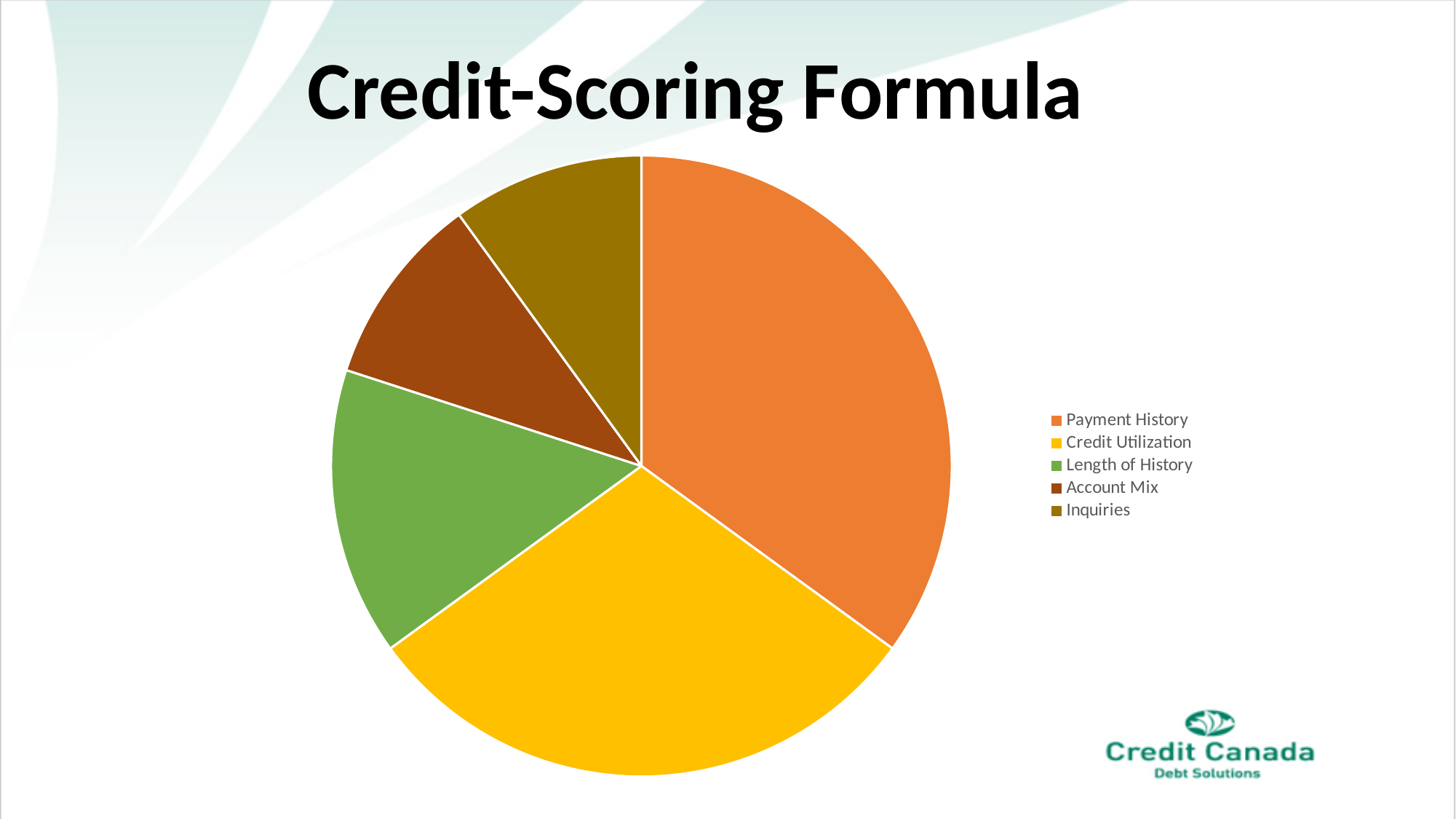
What is the title of the chart on the slide? Credit-Scoring Formula Which category is shown in yellow in the pie chart? Credit Utilization What kind of chart is shown on the slide? pie chart Which slice is larger, Credit Utilization or Length of History? Credit Utilization Which slice is larger, Length of History or Inquiries? Length of History Which category has the largest slice of the pie? Payment History Which slice is larger, Payment History or Credit Utilization? Payment History How many categories does the pie chart show? 5 Which category is listed last in the legend? Inquiries